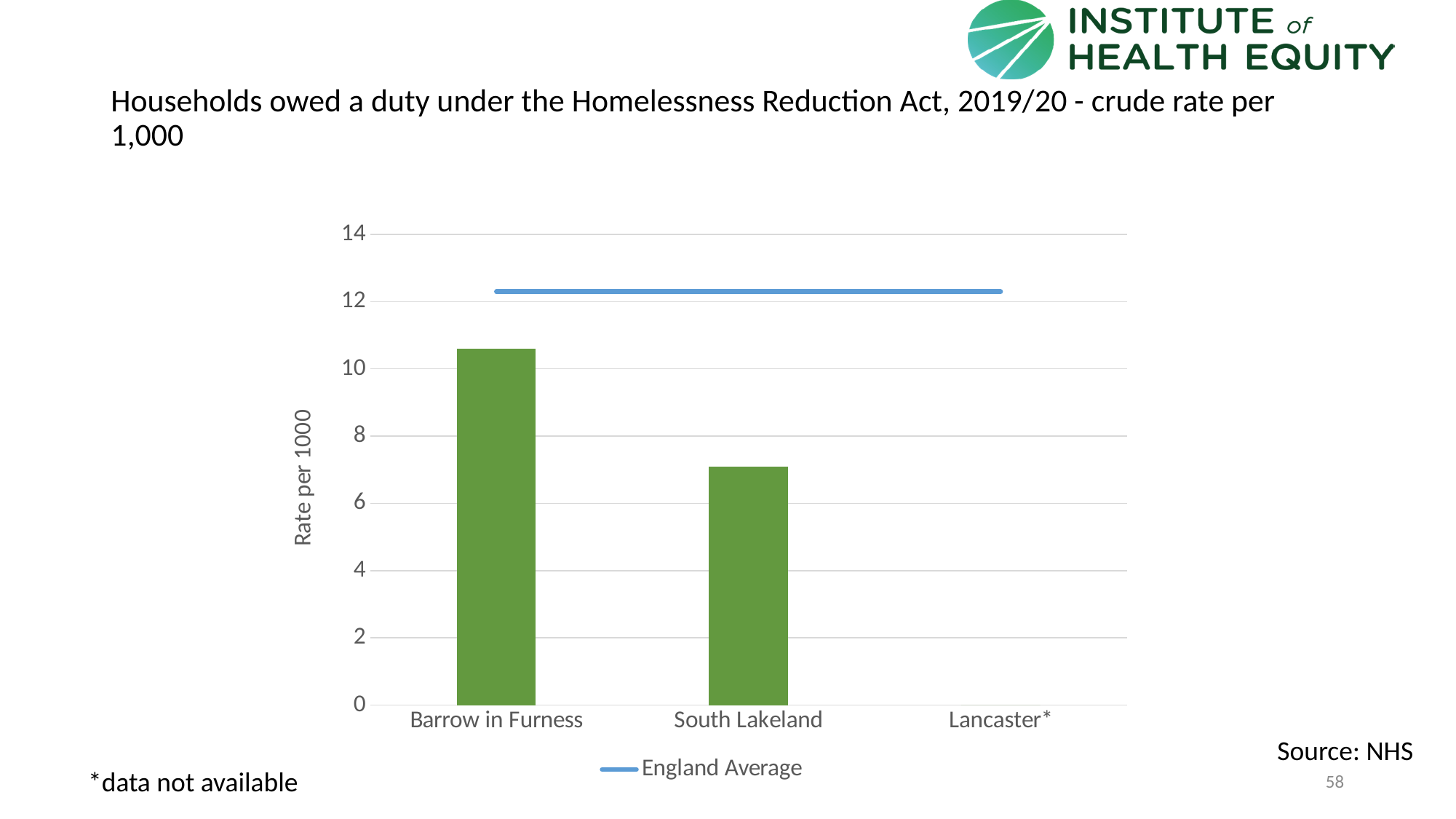
How many categories are shown on the x axis of the chart? 3 Which is larger, the value for Barrow in Furness or the value for South Lakeland? Barrow in Furness What kind of chart is shown on the slide? bar chart Is the value for South Lakeland greater or less than 8? less Which of the two plotted bars is lower, Barrow in Furness or South Lakeland? South Lakeland What is the label on the y axis of the chart? Rate per 1000 What series does the legend of the chart list? England Average Which category has the highest bar in the chart? Barrow in Furness Is the value for Barrow in Furness greater or less than 10? greater Which category on the x axis has no data plotted? Lancaster* Is the England Average line greater or less than 12? greater Is the value for Barrow in Furness greater or less than the England Average line? less